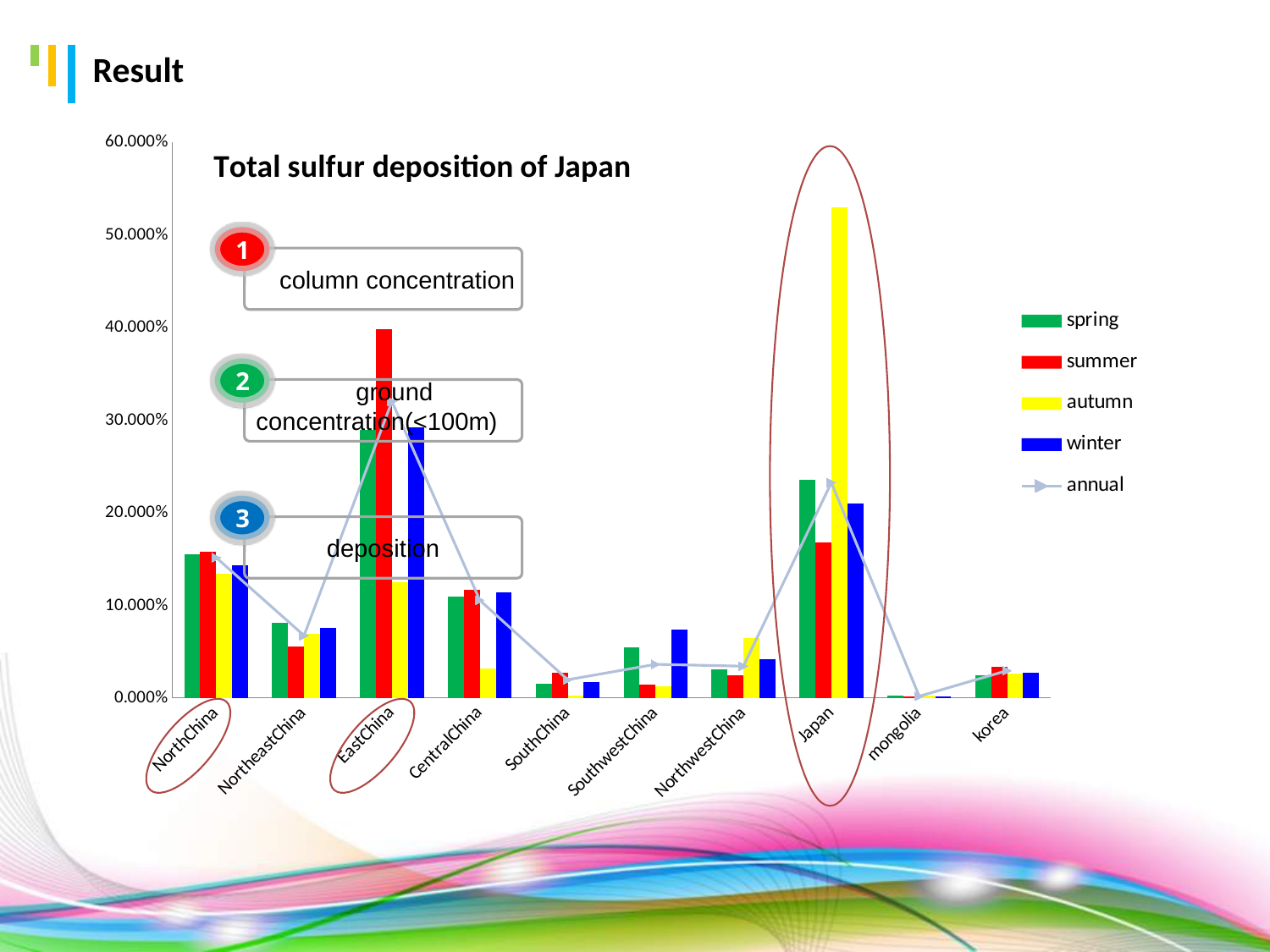
How many categories are shown on the x axis of the chart? 10 Which category has the highest autumn value? Japan Is the spring value for NorthChina greater or less than 10.000%? greater Which colour represents the winter series in the legend? blue Which category has the lowest values overall across all seasons? mongolia Which is larger, the spring value for Japan or the spring value for NorthChina? Japan Is the autumn value for Japan greater or less than 50.000%? greater What is the title of the chart? Total sulfur deposition of Japan How many entries does the chart's legend list? 5 Is the summer value for Japan greater or less than 20.000%? less What kind of chart is used to show the seasonal values (spring, summer, autumn, winter)? bar chart Which category has the highest summer value? EastChina